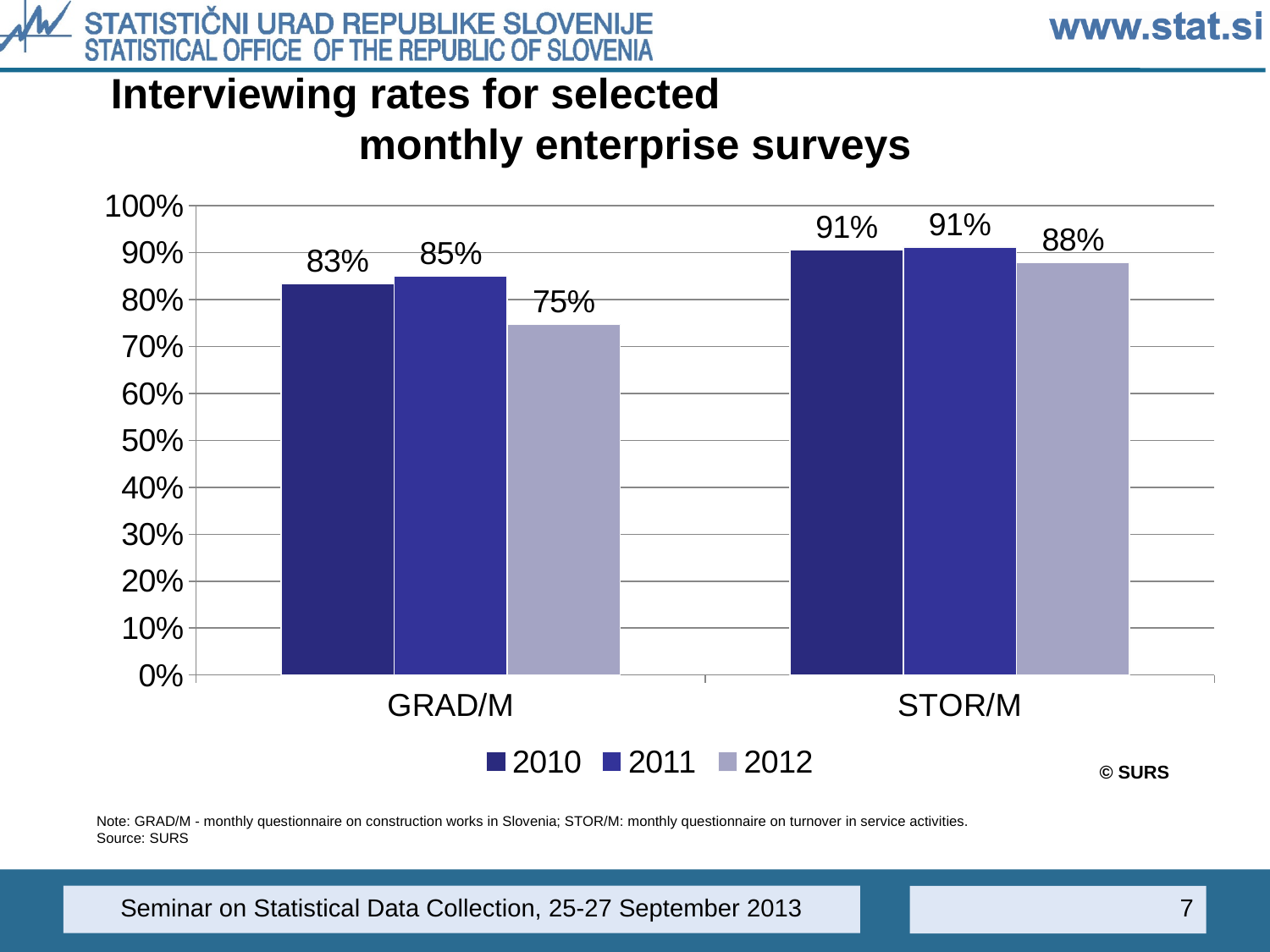
How many series does the legend list? 3 What is the interviewing rate for GRAD/M in 2010? 83% What is the interviewing rate for STOR/M in 2012? 88% What is the difference between the 2011 interviewing rates for STOR/M and GRAD/M? 6% Which years are listed in the chart legend? 2010, 2011, 2012 Which survey has the higher interviewing rate in 2011, GRAD/M or STOR/M? STOR/M What kind of chart is shown on the slide? Bar chart What is the interviewing rate for GRAD/M in 2012? 75% What is the difference between the 2010 and 2012 interviewing rates for GRAD/M? 8% How many survey categories are shown on the x axis? 2 Is the interviewing rate for STOR/M in 2010 greater or less than 80%? greater Which year has the lowest interviewing rate for GRAD/M? 2012